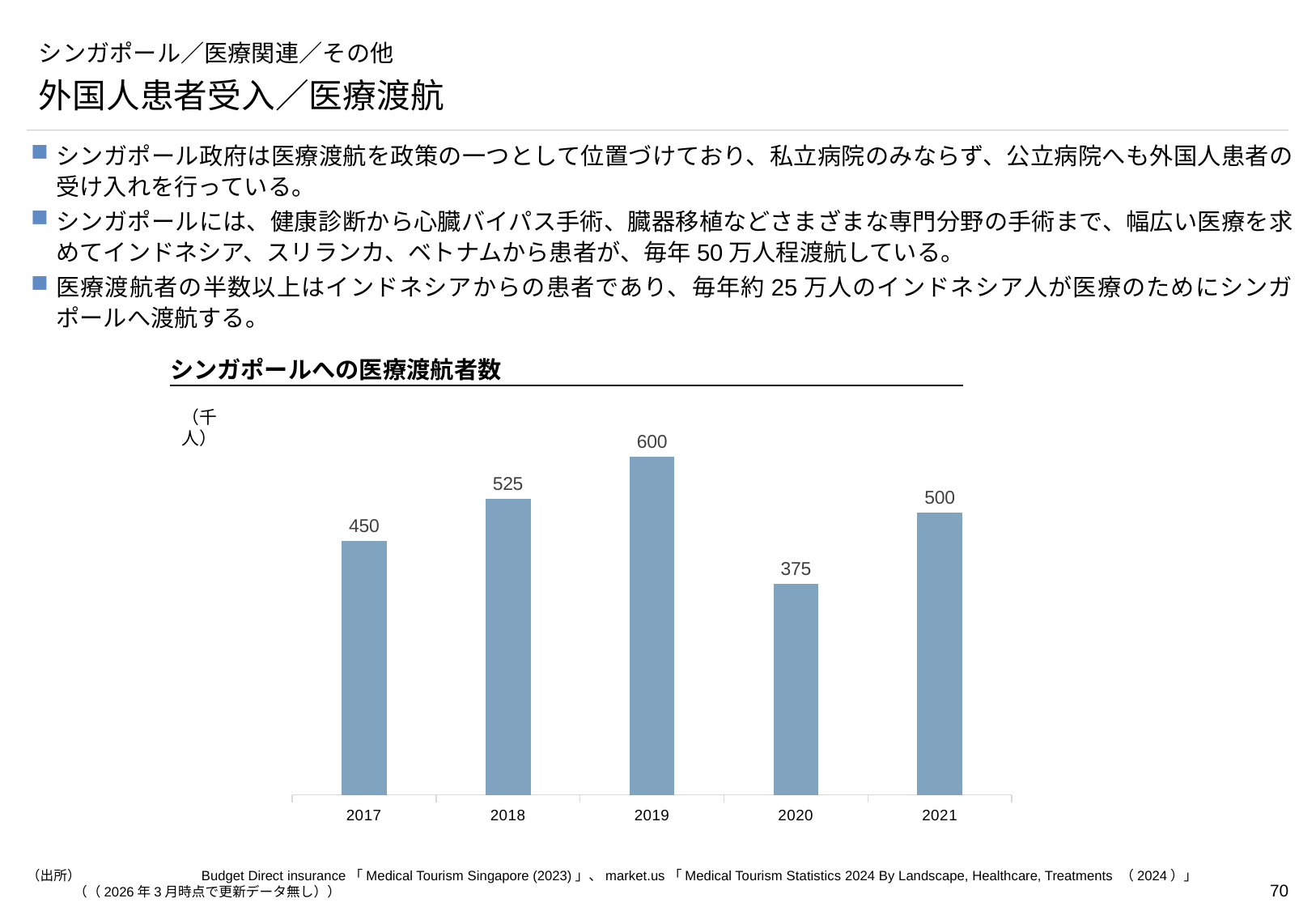
What is the title of the chart? シンガポールへの医療渡航者数 Which is larger, the value for 2018 or the value for 2021? 2018 What is the difference between the values for 2019 and 2020? 225 What kind of chart is shown on the slide? Bar chart What is the difference between the values for 2018 and 2017? 75 Does the value rise or fall from 2019 to 2020? Fall Which year has the highest value in the chart? 2019 Which year has the lowest value in the chart? 2020 What is the value for 2019 in the chart? 600 What is the value for 2020 in the chart? 375 How many years are shown on the x axis of the chart? 5 What is the value for 2017 in the chart? 450